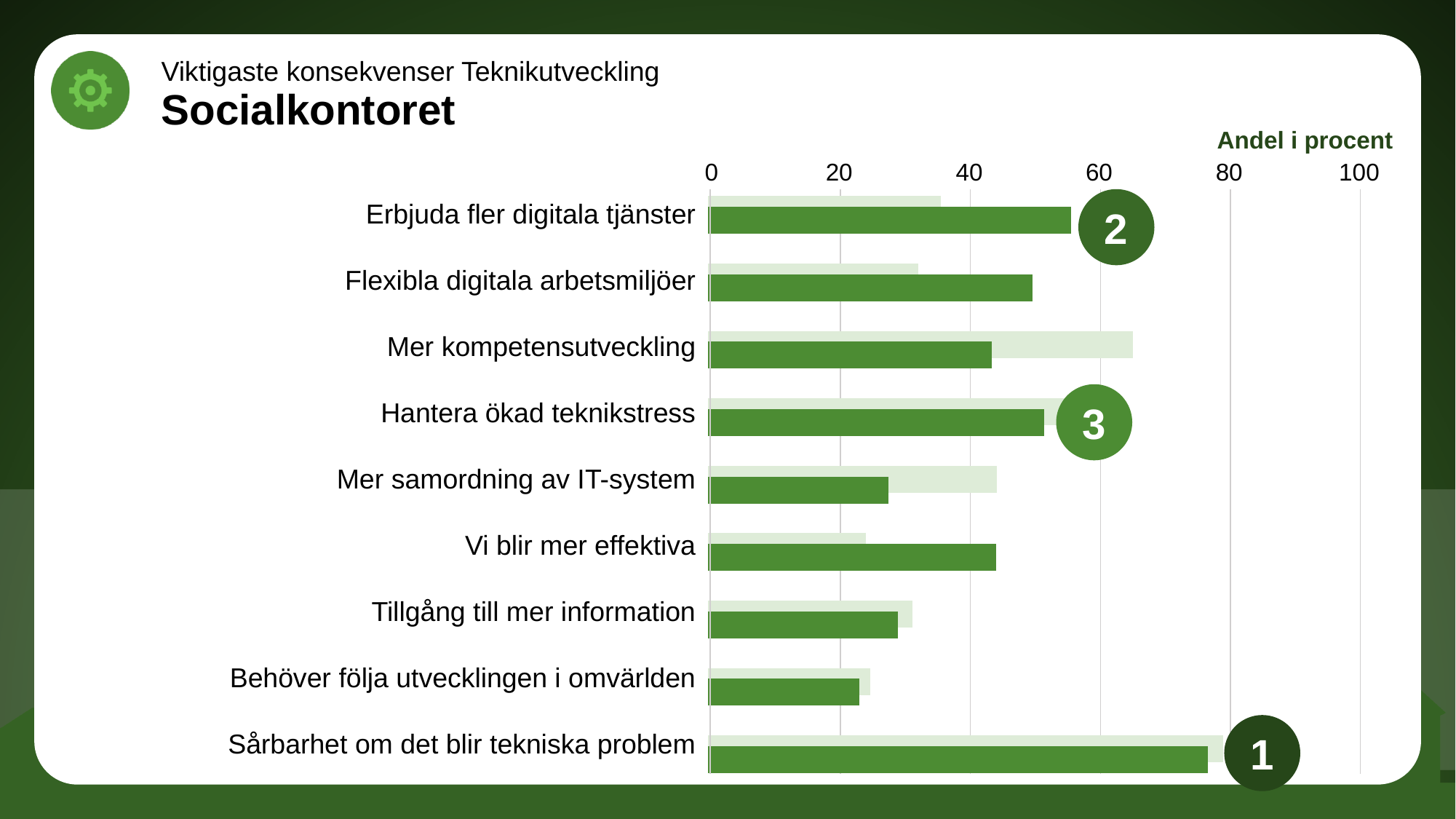
What is the main title of the slide above the chart? Socialkontoret Which category has the longest dark green bar? Sårbarhet om det blir tekniska problem Which category has the longest light green bar? Sårbarhet om det blir tekniska problem Is the light green value for Mer kompetensutveckling greater or less than 60? greater Which category has the shortest dark green bar? Behöver följa utvecklingen i omvärlden Which has the larger dark green bar: Vi blir mer effektiva or Mer samordning av IT-system? Vi blir mer effektiva Is the dark green value for Behöver följa utvecklingen i omvärlden greater or less than 40? less What kind of chart is shown on the slide? bar chart Is the dark green value for Sårbarhet om det blir tekniska problem greater or less than 60? greater How many categories are listed on the chart? 9 What is the label shown above the horizontal axis of the chart? Andel i procent